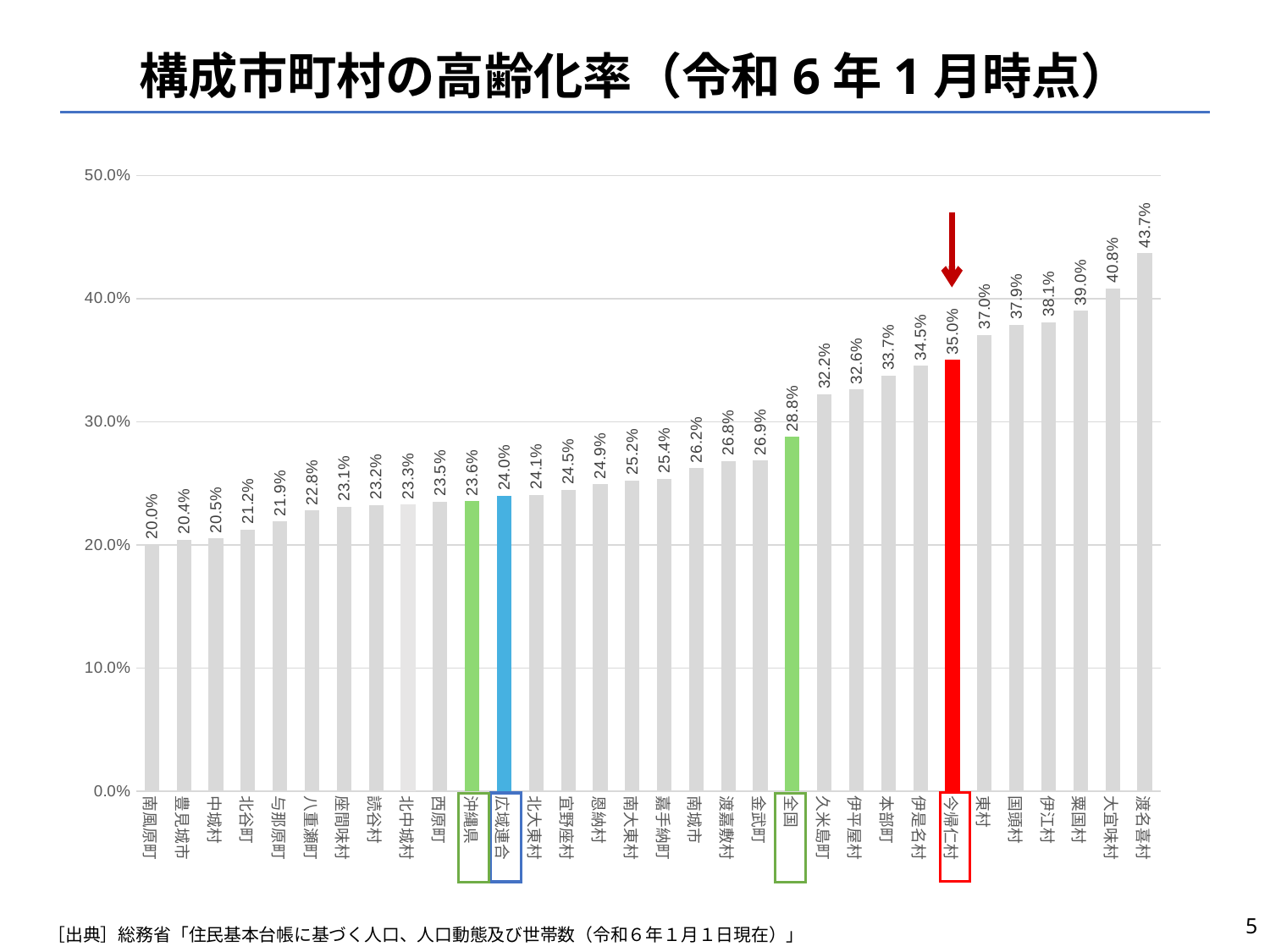
What kind of chart is shown on the slide? bar chart What is the value for 今帰仁村? 35.0% What is the value for 広域連合? 24.0% Which is larger, the value for 久米島町 or the value for 本部町? 本部町 What is the value for 全国? 28.8% What is the difference between the values for 渡名喜村 and 全国? 14.9% Which category has the highest value? 渡名喜村 How many categories are shown on the x axis? 32 Which bar is coloured red? 今帰仁村 Which category has the lowest value? 南風原町 Is the value for 大宜味村 greater or less than 40.0%? greater What is the difference between the values for 今帰仁村 and 沖縄県? 11.4%